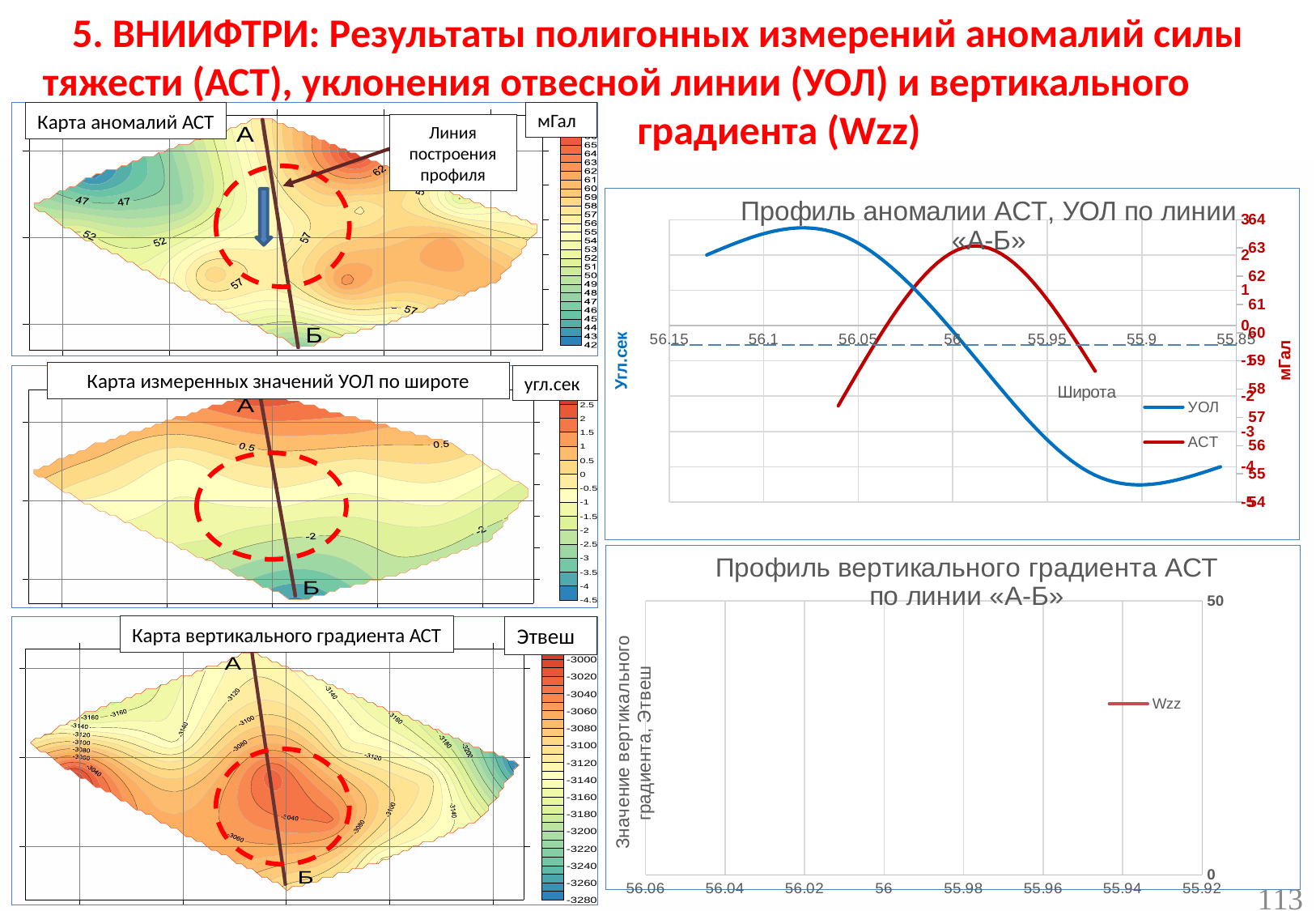
In the chart «Профиль аномалии АСТ, УОЛ по линии «А-Б»», is the УОЛ value at latitude 56.1 greater or less than 2 on the left axis? greater In the chart «Профиль аномалии АСТ, УОЛ по линии «А-Б»», is the УОЛ value at latitude 55.9 greater or less than -3 on the left axis? less How many series does the legend of the chart «Профиль аномалии АСТ, УОЛ по линии «А-Б»» list? 2 What kind of chart is the chart titled «Профиль аномалии АСТ, УОЛ по линии «А-Б»»? line chart In the chart «Профиль аномалии АСТ, УОЛ по линии «А-Б»», does the АСТ series rise or fall between latitude 56.05 and latitude 55.98? rise In the chart «Профиль аномалии АСТ, УОЛ по линии «А-Б»», is the АСТ value at latitude 55.98 greater or less than 62 on the right axis? greater What is the name of the series in the legend of the chart «Профиль вертикального градиента АСТ по линии «А-Б»»? Wzz How many latitude tick labels are shown on the x axis of the chart «Профиль вертикального градиента АСТ по линии «А-Б»»? 8 In the chart «Профиль аномалии АСТ, УОЛ по линии «А-Б»», is the УОЛ value larger at latitude 56.1 or at latitude 55.9? 56.1 In the chart «Профиль аномалии АСТ, УОЛ по линии «А-Б»», does the УОЛ series rise or fall between latitude 56.05 and latitude 55.9? fall How many series does the legend of the chart «Профиль вертикального градиента АСТ по линии «А-Б»» list? 1 In the chart «Профиль аномалии АСТ, УОЛ по линии «А-Б»», which series is drawn in blue? УОЛ